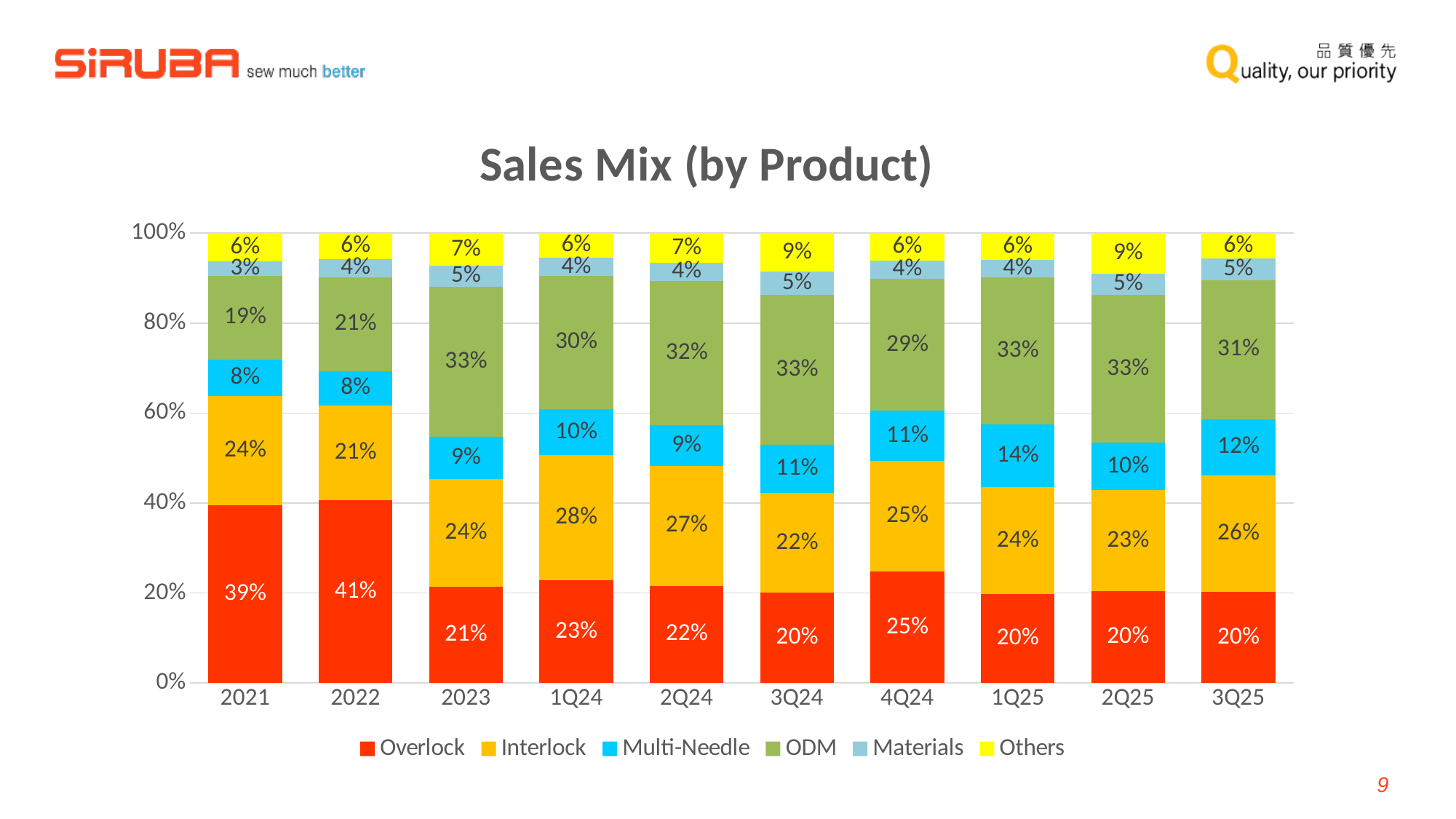
What is the difference between the ODM share in 2023 and the ODM share in 2021? 14% Does the Overlock share rise or fall from 2021 to 2023? Fall In which period is the Materials share lowest? 2021 How many series does the legend list? 6 In which period is the Overlock share highest? 2022 What is the ODM share in 3Q25? 31% What is the Overlock share in 2022? 41% What is the Interlock share in 1Q24? 28% How many periods are shown on the x axis? 10 What kind of chart is shown? Stacked bar chart Which is larger in 4Q24: the Overlock share or the ODM share? ODM What is the Multi-Needle share in 1Q25? 14%